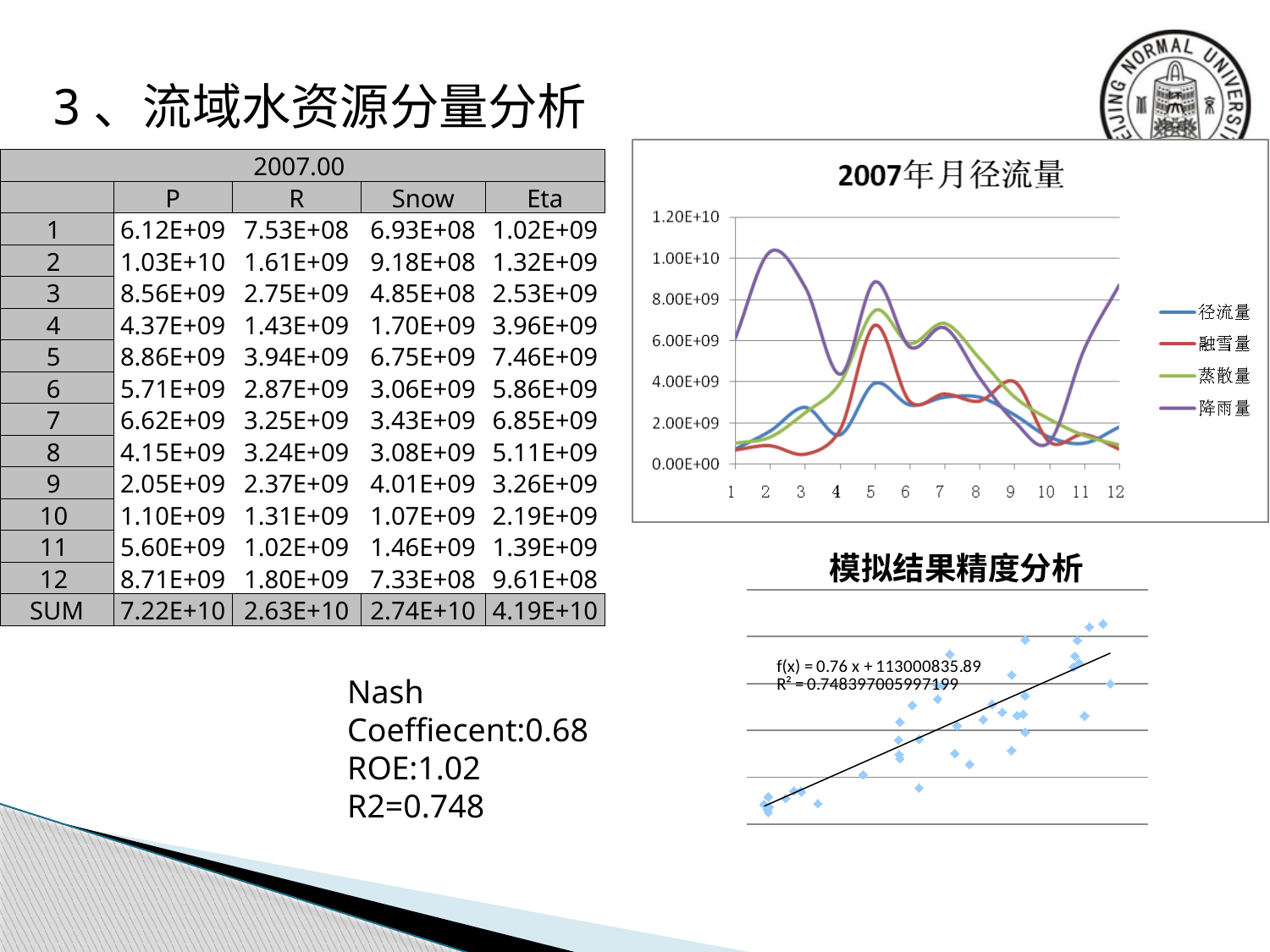
What R² value is shown on the 模拟结果精度分析 chart? 0.748397005997199 In the 2007年月径流量 chart, at month 5, which is larger: 融雪量 or 径流量? 融雪量 What is the trendline equation shown on the 模拟结果精度分析 chart? f(x) = 0.76 x + 113000835.89 In the 2007年月径流量 chart, is the value of 径流量 at month 5 greater or less than 6.00E+09? less In the 2007年月径流量 chart, is the peak value of 降雨量 greater or less than 8.00E+09? greater In the 2007年月径流量 chart, is the value of 融雪量 at month 5 greater or less than 8.00E+09? less What kind of chart is the chart titled 模拟结果精度分析? scatter chart In the 2007年月径流量 chart, which series reaches the highest value overall? 降雨量 How many series does the legend of the 2007年月径流量 chart list? 4 What kind of chart is the chart titled 2007年月径流量? line chart In the 2007年月径流量 chart, does 降雨量 rise or fall from month 2 to month 4? fall How many months are plotted along the x axis of the 2007年月径流量 chart? 12